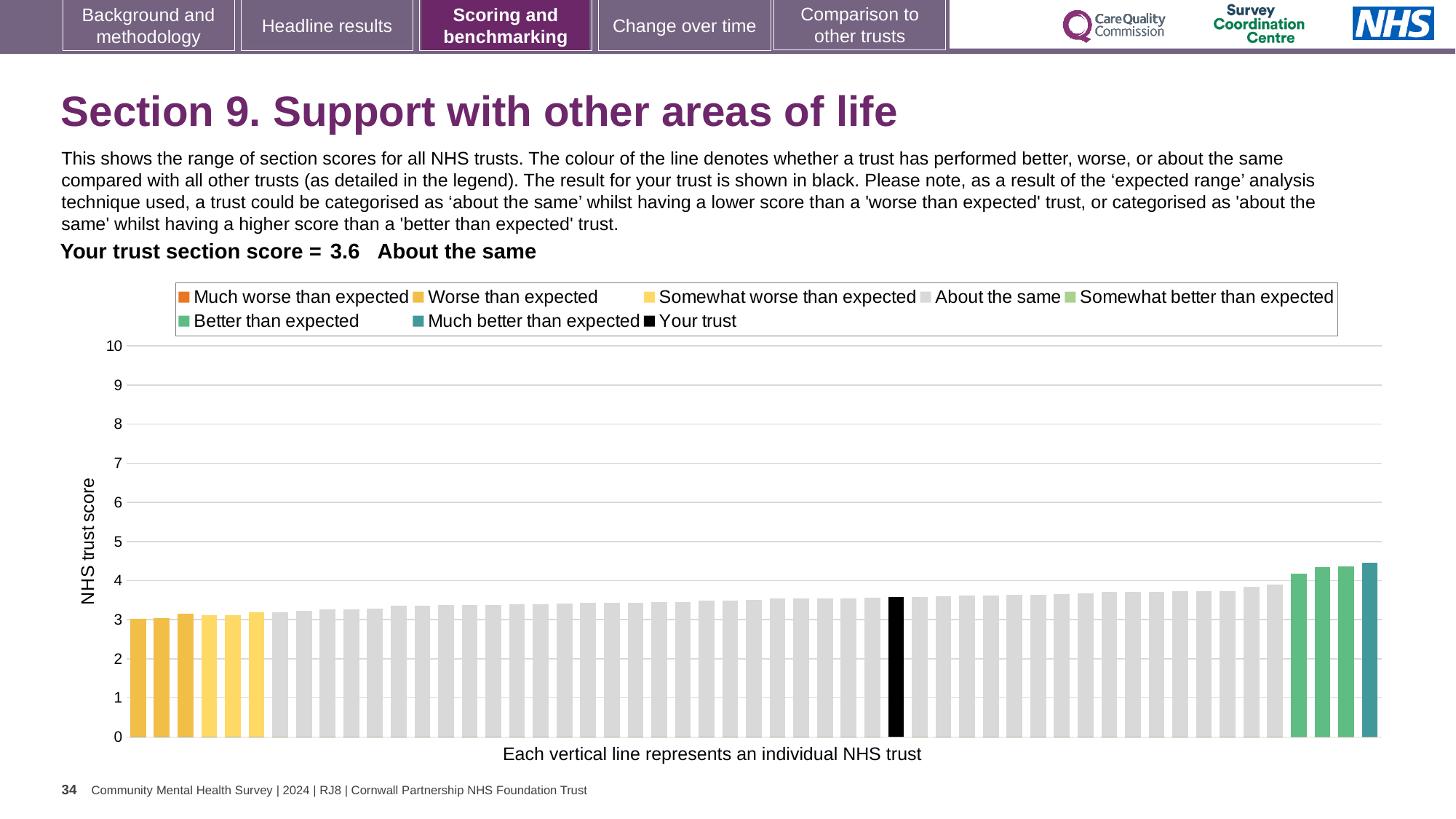
Is the value for the tallest bar greater or less than 4? greater Which performance category is your trust placed in? About the same What is the label on the vertical axis of the chart? NHS trust score Which legend category does the shortest bar belong to? Worse than expected Is the value for the leftmost (lowest) bar greater or less than 4? less Which legend category does the tallest bar belong to? Much better than expected Do the bar values rise or fall from left to right along the x axis? rise Is the value for your trust's bar greater or less than 3? greater What is the section score for your trust? 3.6 How many entries does the chart legend list? 8 Is your trust's bar higher or lower than the leftmost bar? higher What kind of chart is shown on the slide? bar chart